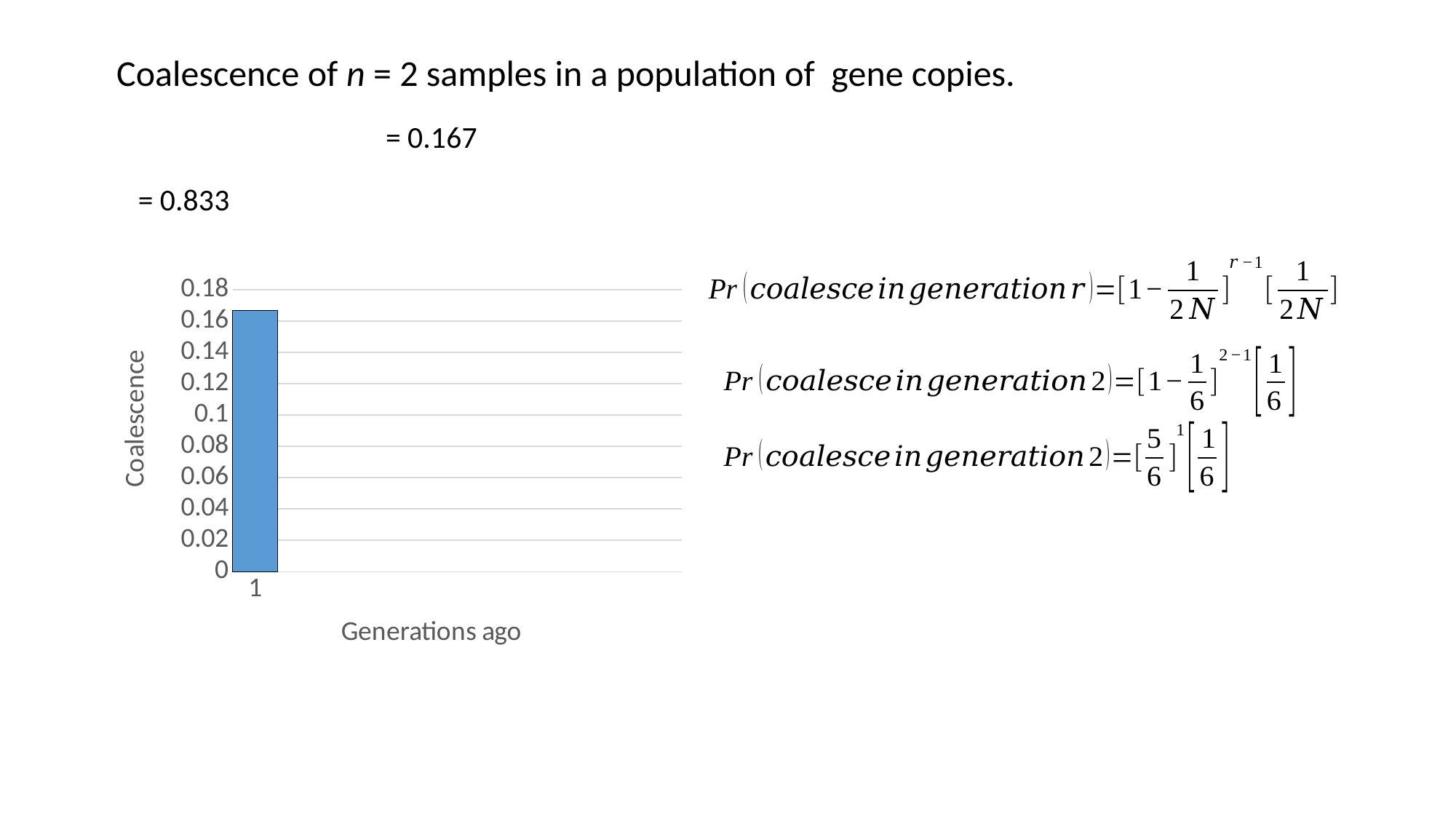
What is the label on the horizontal axis of the chart? Generations ago What is the category label shown under the single bar? 1 What is the highest value shown on the vertical axis of the chart? 0.18 Is the value of the bar for generation 1 greater or less than 0.1? greater What kind of chart is shown on the slide? bar chart How many bars are plotted in the chart? 1 Is the value of the bar for generation 1 greater or less than 0.14? greater What is the label on the vertical axis of the chart? Coalescence Is the value of the bar for generation 1 greater or less than 0.18? less